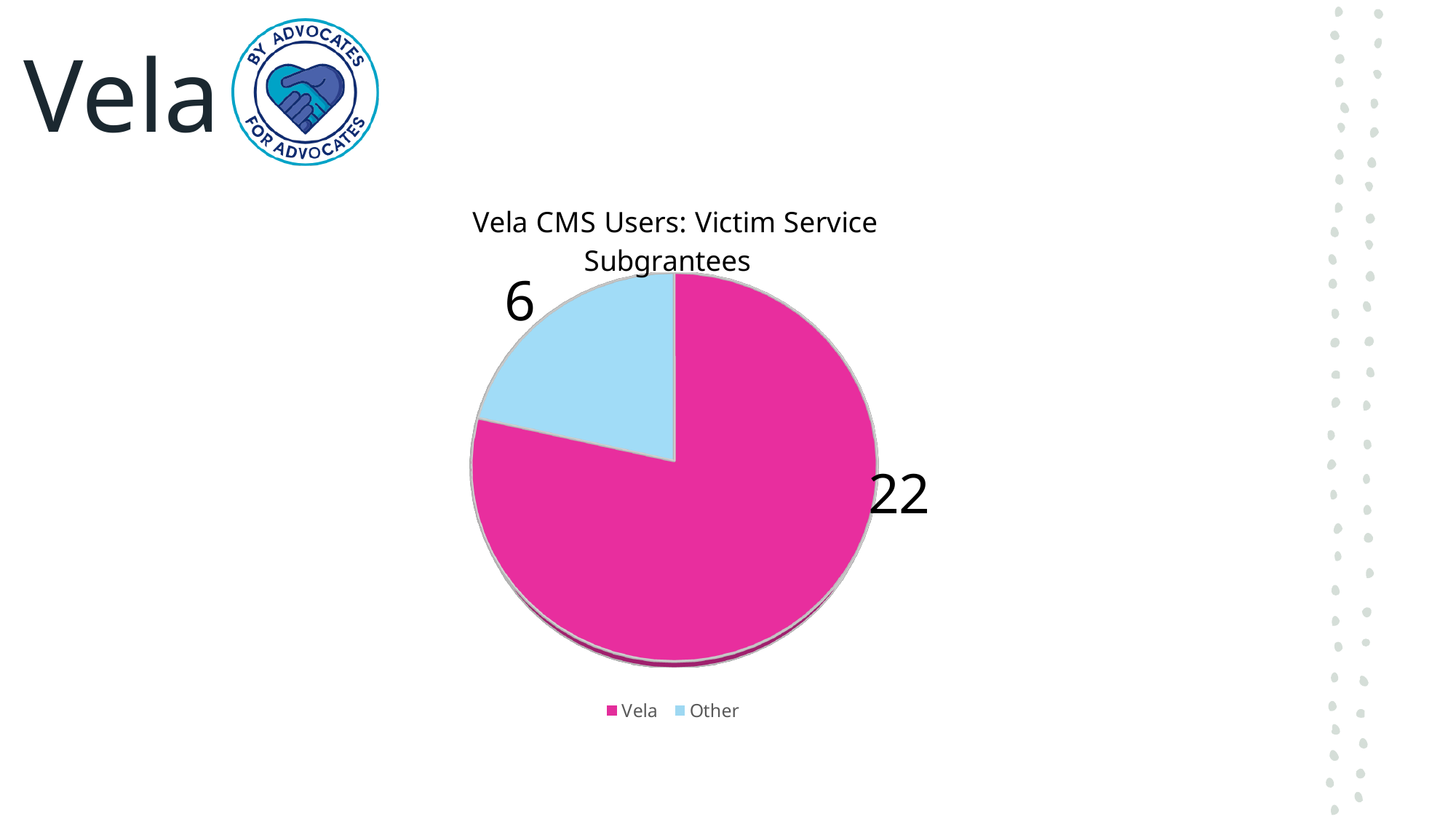
What is the value for Other? 6 Which is larger, the value for Vela or the value for Other? Vela What is the total of all slices in the pie chart? 28 What is the value for Vela? 22 Which category has the largest slice? Vela What kind of chart is shown on the slide? Pie chart How many slices does the pie chart have? 2 How many entries does the legend list? 2 Which category has the smallest slice? Other What colour is the Other slice? Light blue What is the difference between the values for Vela and Other? 16 What is the title of the chart? Vela CMS Users: Victim Service Subgrantees